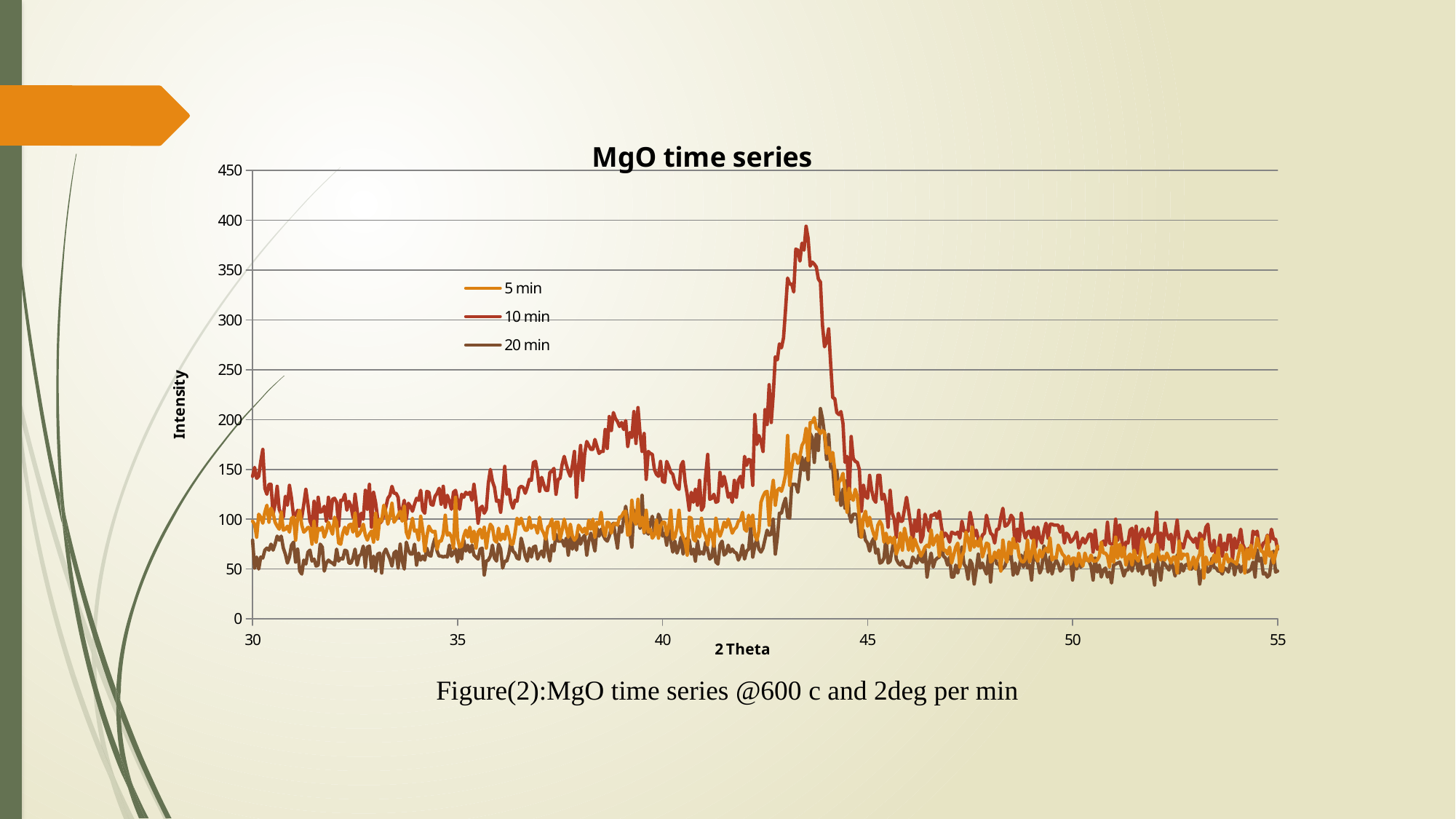
Is the peak intensity of the 5 min series greater or less than 250? less Does the highest peak of the 10 min series occur at a 2 Theta value greater or less than 45? less Is the peak intensity of the 10 min series greater or less than 350? greater What is the title of the chart? MgO time series What are the labels of the x axis and the y axis of the chart? 2 Theta and Intensity Which series reaches the highest peak intensity? 10 min Between 2 Theta 30 and 35, which series has the lowest intensity? 20 min How many series does the legend of the MgO time series chart list? 3 At the main peak near 2 Theta 43-44, which series has the higher intensity, 10 min or 5 min? 10 min What kind of chart is shown on the slide? line chart